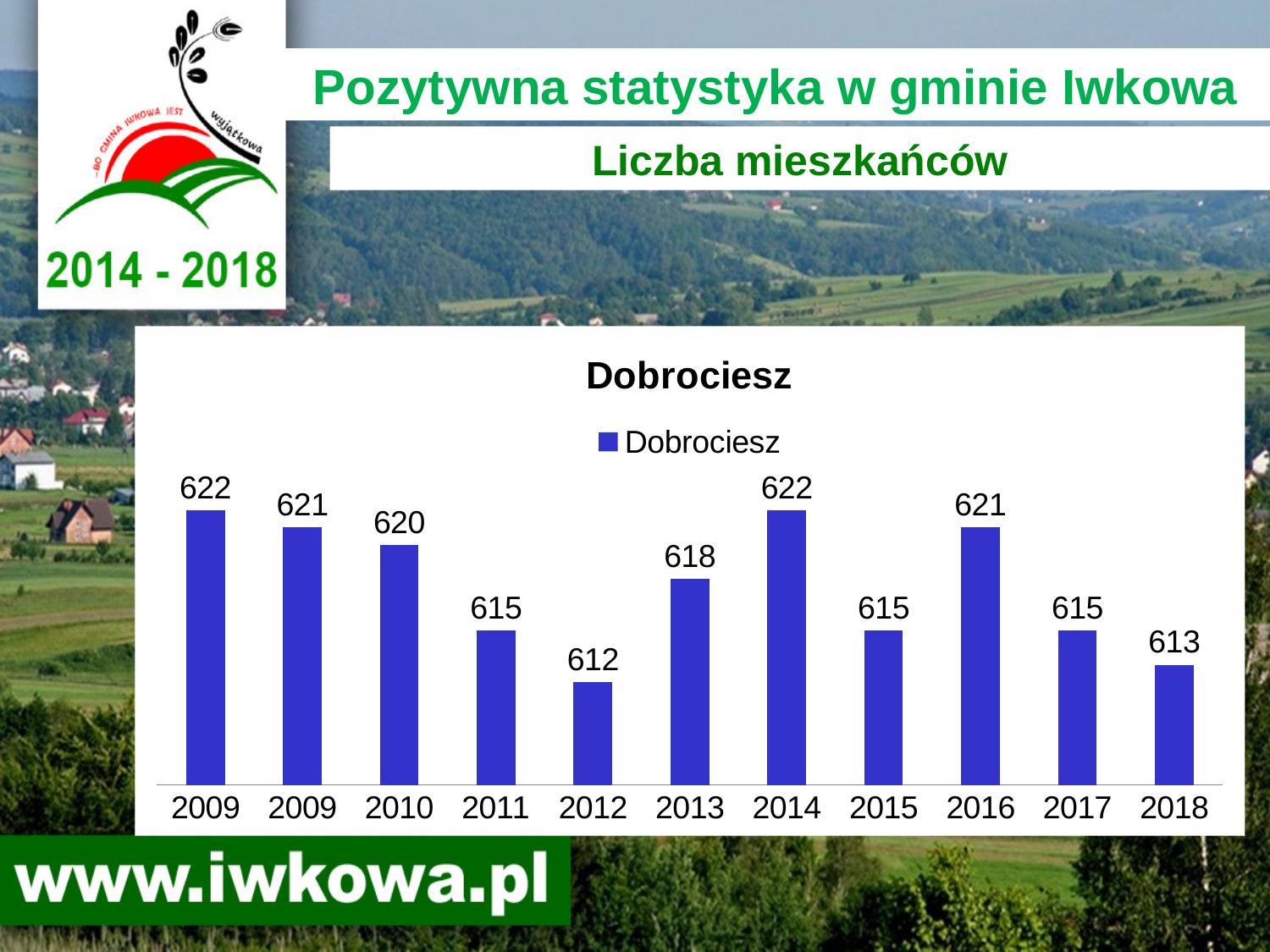
What is the value shown for 2014 in the Dobrociesz chart? 622 How many bars are shown in the Dobrociesz chart? 11 Which year has the lowest value in the Dobrociesz chart? 2012 What is the value shown for 2016 in the Dobrociesz chart? 621 Which is larger, the value for 2013 or the value for 2015? 2013 What is the highest value shown in the Dobrociesz chart? 622 What kind of chart is shown on the slide? bar chart What is the value shown for 2018 in the Dobrociesz chart? 613 How many series does the legend list? 1 What is the difference between the values for 2016 and 2018? 8 What is the difference between the values for 2014 and 2012? 10 What is the number of residents of Dobrociesz in 2012? 612